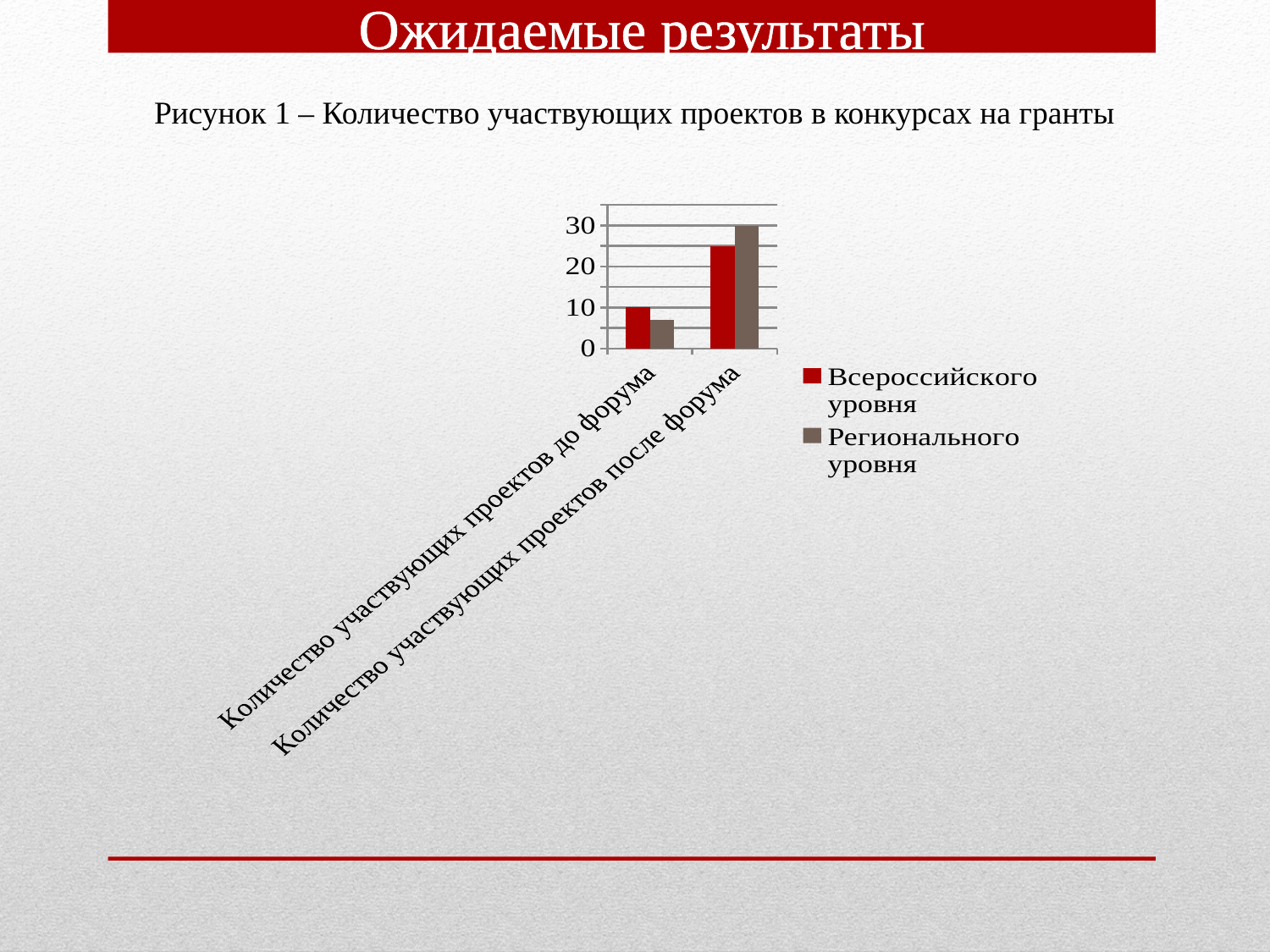
How many series does the legend list? 2 What is the value for Регионального уровня in the category Количество участвующих проектов после форума? 30 In the category Количество участвующих проектов после форума, which series has the larger value? Регионального уровня What is the value for Всероссийского уровня in the category Количество участвующих проектов до форума? 10 Is the value for Регионального уровня in the category Количество участвующих проектов до форума greater or less than 10? less Do the values for both series rise or fall from the category до форума to the category после форума? rise Is the value for Всероссийского уровня in the category Количество участвующих проектов после форума greater or less than 20? greater How many categories are shown on the x axis? 2 What kind of chart is shown on the slide? bar chart In the category Количество участвующих проектов до форума, which series has the larger value? Всероссийского уровня Which bar is the highest in the chart? Регионального уровня, Количество участвующих проектов после форума What colour represents the series Всероссийского уровня in the legend? red